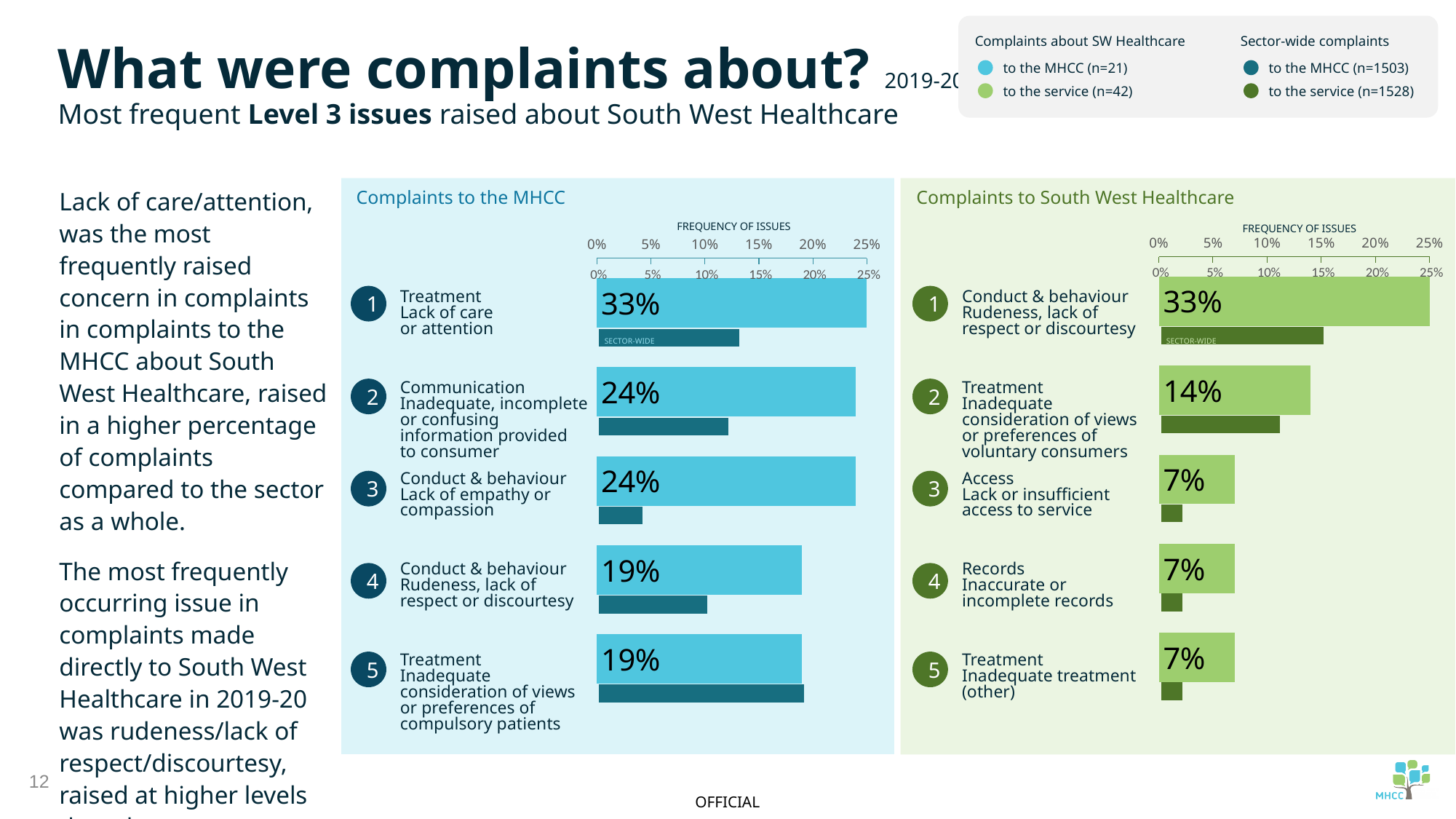
How many issues are listed in the 'Complaints to the MHCC' chart? 5 According to the legend, how many complaints about SW Healthcare were made to the MHCC? n=21 In the 'Complaints to South West Healthcare' chart, is the sector-wide value for 'Conduct & behaviour – Rudeness, lack of respect or discourtesy' greater or less than 10%? greater In the 'Complaints to the MHCC' chart, is the sector-wide value for 'Conduct & behaviour – Lack of empathy or compassion' greater or less than 10%? less In the 'Complaints to the MHCC' chart, which has a higher frequency: 'Communication – Inadequate, incomplete or confusing information provided to consumer' or 'Conduct & behaviour – Rudeness, lack of respect or discourtesy'? Communication – Inadequate, incomplete or confusing information provided to consumer In the 'Complaints to South West Healthcare' chart, what is the frequency for 'Treatment – Inadequate consideration of views or preferences of voluntary consumers'? 14% In the 'Complaints to the MHCC' chart, what is the frequency for 'Treatment – Lack of care or attention'? 33% In the 'Complaints to South West Healthcare' chart, what is the frequency for 'Access – Lack or insufficient access to service'? 7% In the 'Complaints to South West Healthcare' chart, which issue has the highest frequency? Conduct & behaviour – Rudeness, lack of respect or discourtesy In the 'Complaints to South West Healthcare' chart, what is the difference between the top issue (33%) and the second issue (14%)? 19 percentage points In the 'Complaints to the MHCC' chart, what is the difference between the frequency for 'Treatment – Lack of care or attention' and 'Conduct & behaviour – Rudeness, lack of respect or discourtesy'? 14 percentage points What kind of chart is the 'Complaints to South West Healthcare' chart? Bar chart